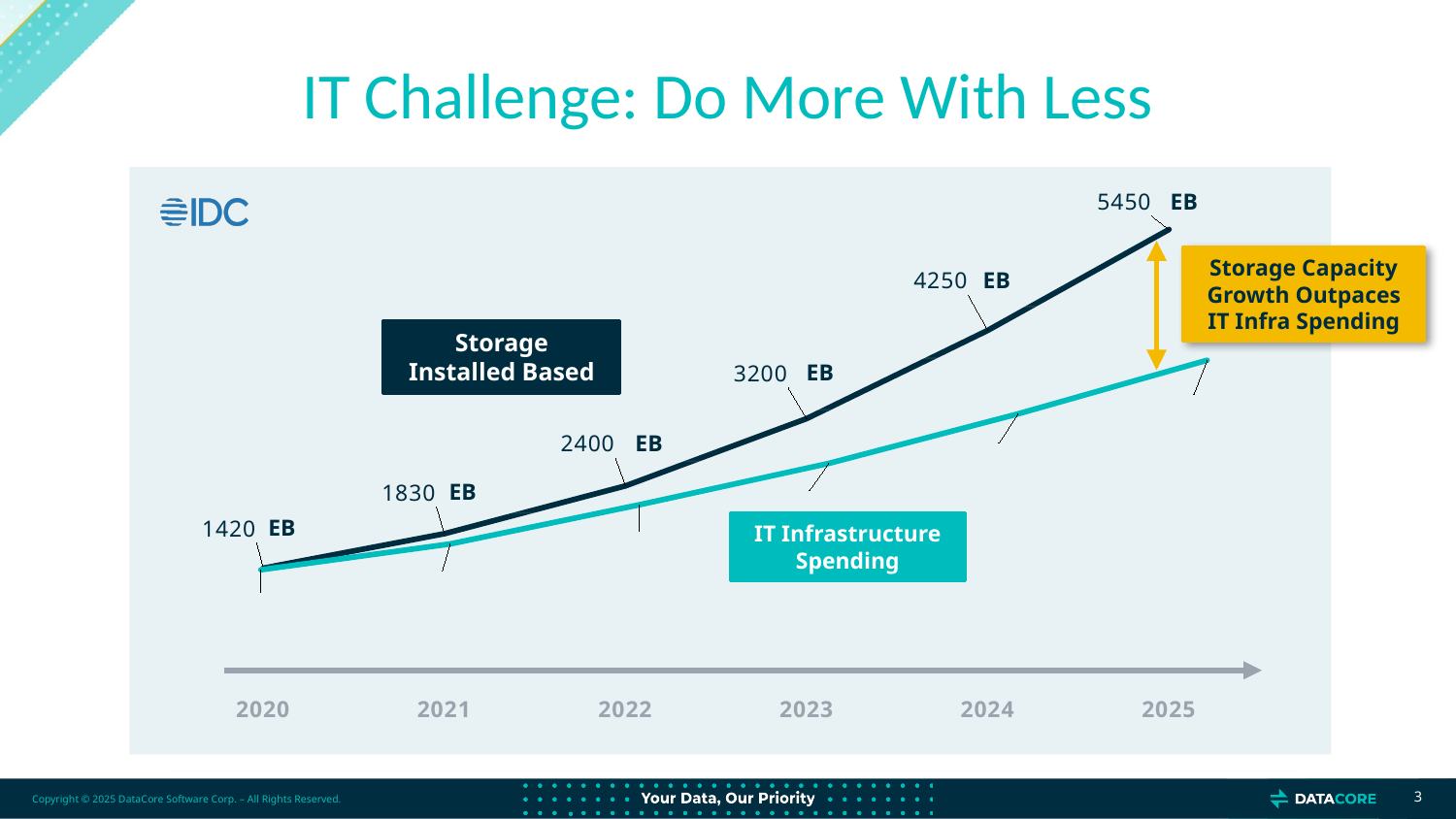
How many years are shown on the x axis? 6 In which year is the Storage Installed Base highest? 2025 Does the Storage Installed Base rise or fall from 2020 to 2025? rise What is the Storage Installed Base value for 2025? 5450 EB What kind of chart is shown on the slide? line chart In 2025, which line is higher: Storage Installed Base or IT Infrastructure Spending? Storage Installed Base What is the difference between the Storage Installed Base in 2025 and in 2020? 4030 EB What is the Storage Installed Base value for 2022? 2400 EB What is the Storage Installed Base value for 2024? 4250 EB In which year is the Storage Installed Base lowest? 2020 What is the Storage Installed Base value for 2020? 1420 EB What is the difference between the Storage Installed Base in 2024 and in 2023? 1050 EB